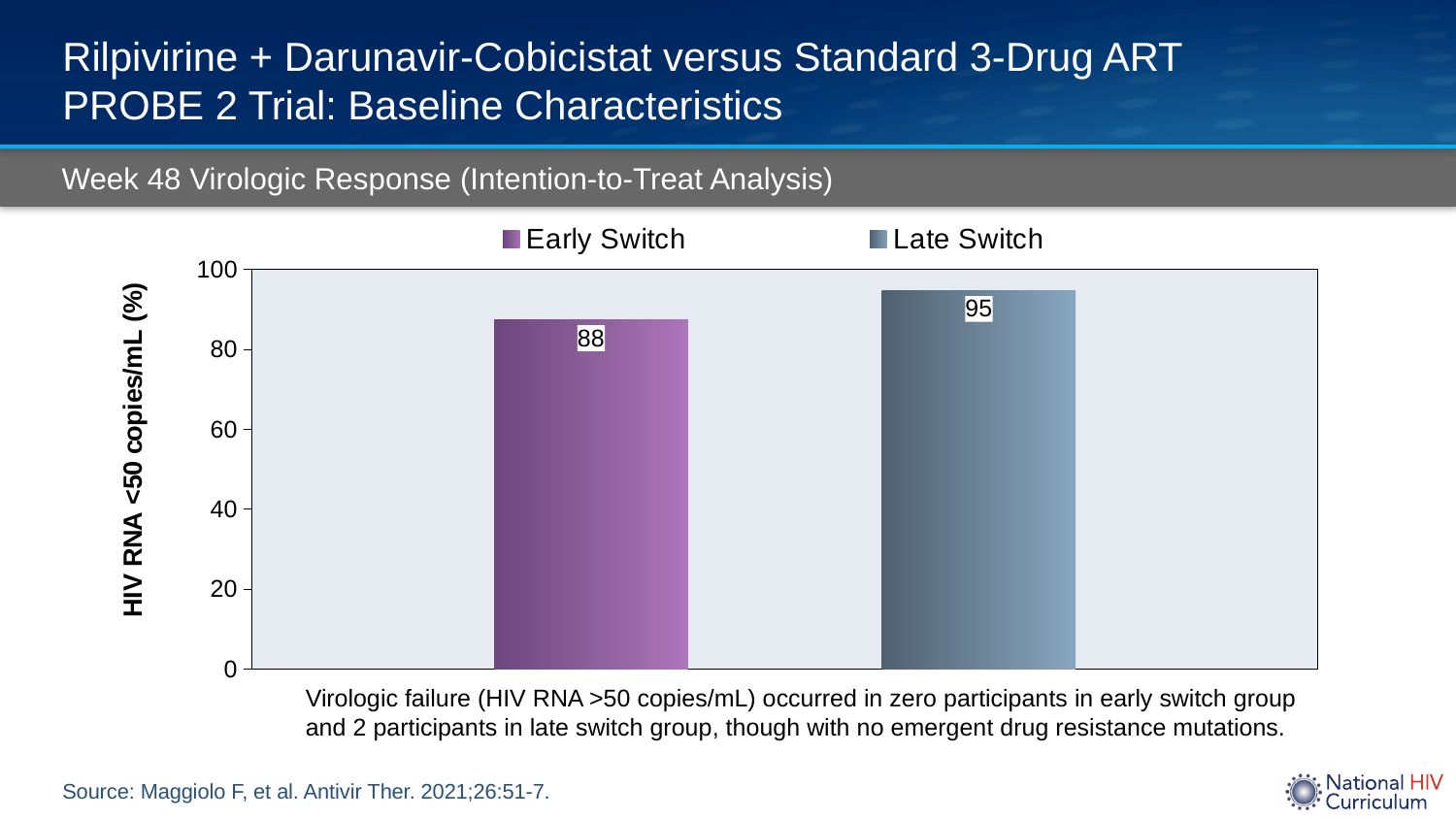
How many series does the legend list? 2 Which group has the higher value, Early Switch or Late Switch? Late Switch Is the value for Late Switch greater or less than 100? less What is the value for Late Switch? 95 What is the title of the chart? Week 48 Virologic Response (Intention-to-Treat Analysis) How many bars are plotted in the chart? 2 What kind of chart is shown on the slide? Bar chart What is the label of the y axis? HIV RNA <50 copies/mL (%) Which group has the lower value? Early Switch What is the value for Early Switch? 88 Is the value for Early Switch greater or less than 80? greater What is the difference between the Late Switch and Early Switch values? 7